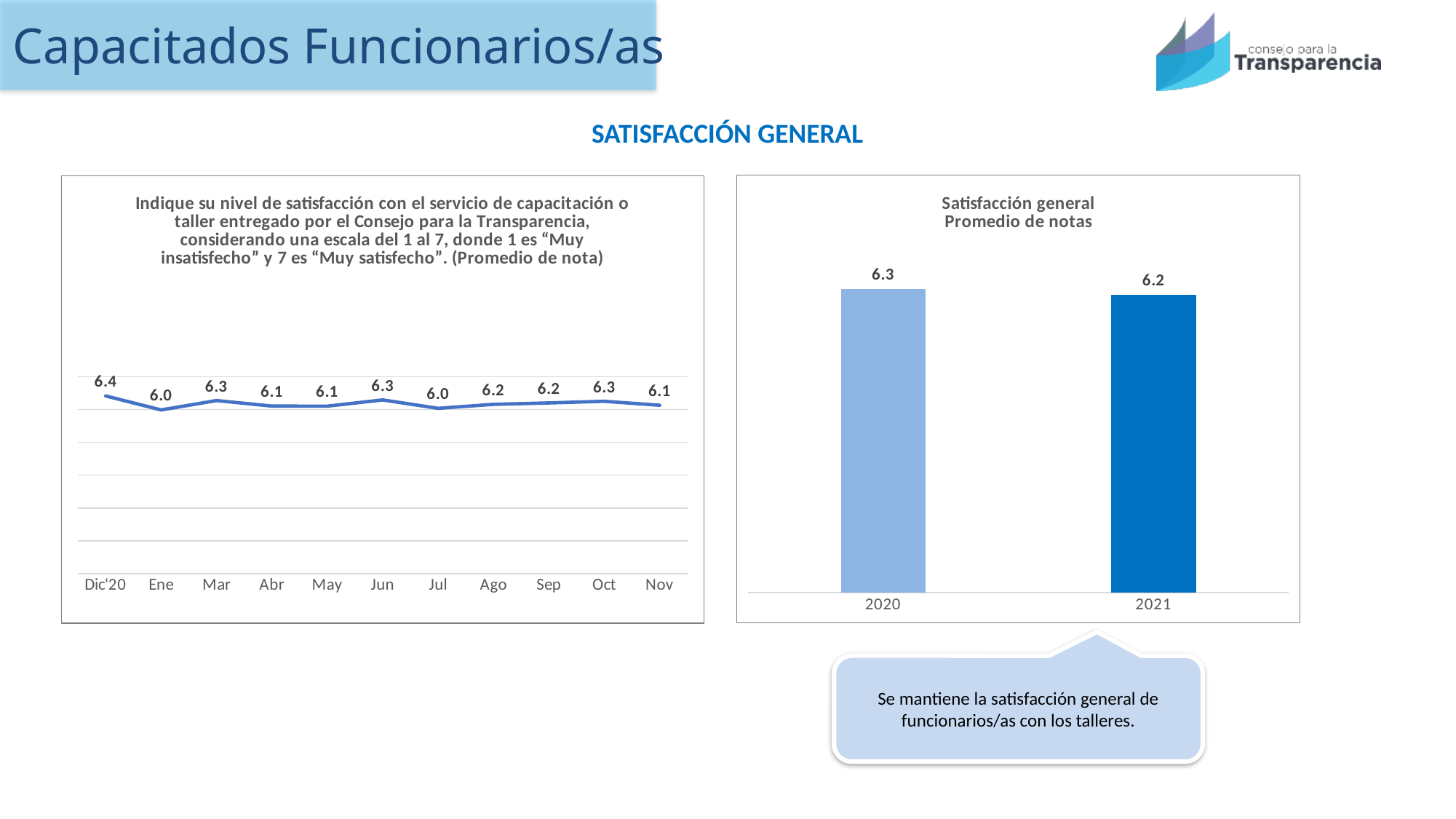
In the right chart 'Satisfacción general Promedio de notas', how many bars are shown? 2 In the right chart 'Satisfacción general Promedio de notas', what is the value for 2020? 6.3 In the left line chart, which month has the highest value? Dic'20 What kind of chart is the chart on the right? bar chart In the right chart 'Satisfacción general Promedio de notas', what is the difference between the 2020 and 2021 values? 0.1 In the left line chart, what is the value for Dic'20? 6.4 What kind of chart is the chart on the left? line chart In the left line chart, what is the difference between the values for Dic'20 and Ene? 0.4 In the left line chart, which is larger, the value for Mar or the value for Jul? Mar In the left line chart, what is the value for Jun? 6.3 In the right chart 'Satisfacción general Promedio de notas', what is the value for 2021? 6.2 In the left line chart, how many data points are plotted? 11